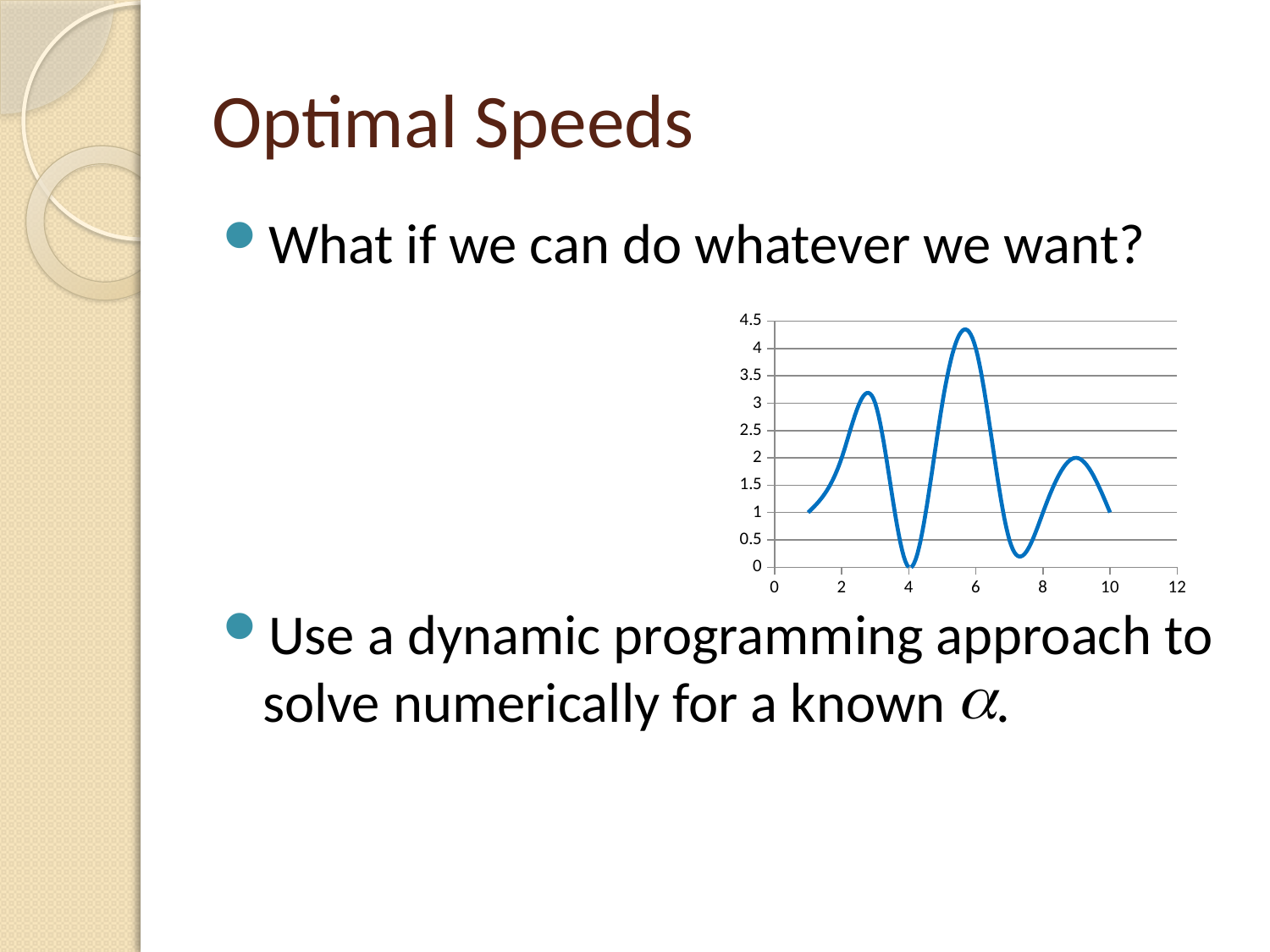
Is the value of the curve at x = 4 greater or less than 0.5? less Which is larger, the peak near x = 3 or the peak near x = 9? the peak near x = 3 How many series does the chart plot? 1 How many peaks (local maxima) does the curve have? 3 Is the highest point of the curve greater or less than 4? greater Around which x value does the curve reach its highest point: near 3, near 6, or near 9? near 6 Is the value of the curve at x = 2 greater or less than 1? greater What colour is the plotted line? blue What is the maximum value shown on the y axis? 4.5 What kind of chart is shown on the slide? line chart